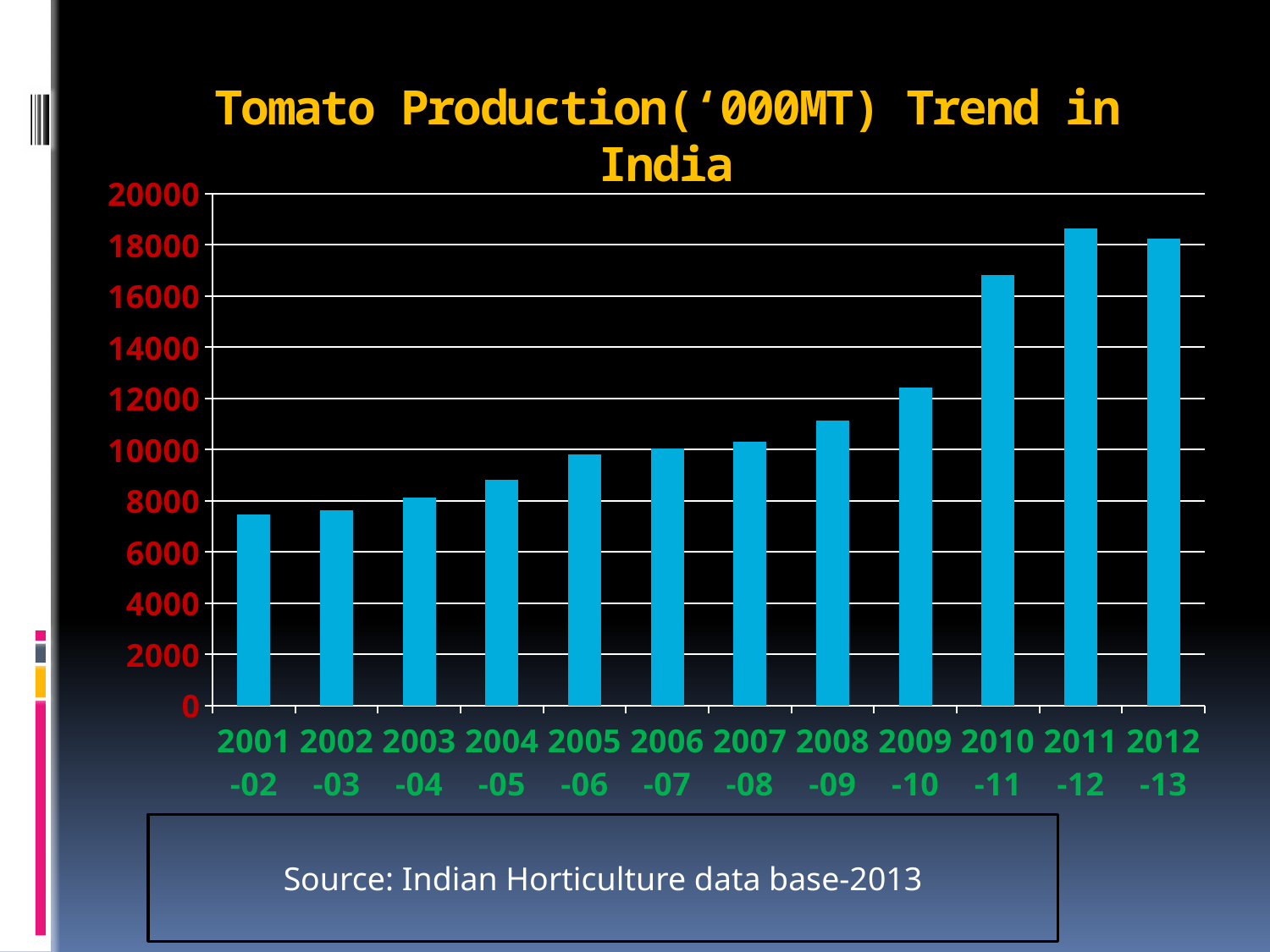
Is the value for 2009-10 greater or less than 12000? greater Do the values generally rise or fall from 2001-02 to 2011-12? rise What kind of chart is shown on the slide? Bar chart Is the value for 2001-02 greater or less than 8000? less How many years (categories) are plotted on the x axis? 12 What is the title of the chart? Tomato Production('000MT) Trend in India Which year has the highest tomato production? 2011-12 Which is larger, the value for 2009-10 or the value for 2010-11? 2010-11 Is the value for 2005-06 greater or less than 10000? less Which is larger, the value for 2003-04 or the value for 2008-09? 2008-09